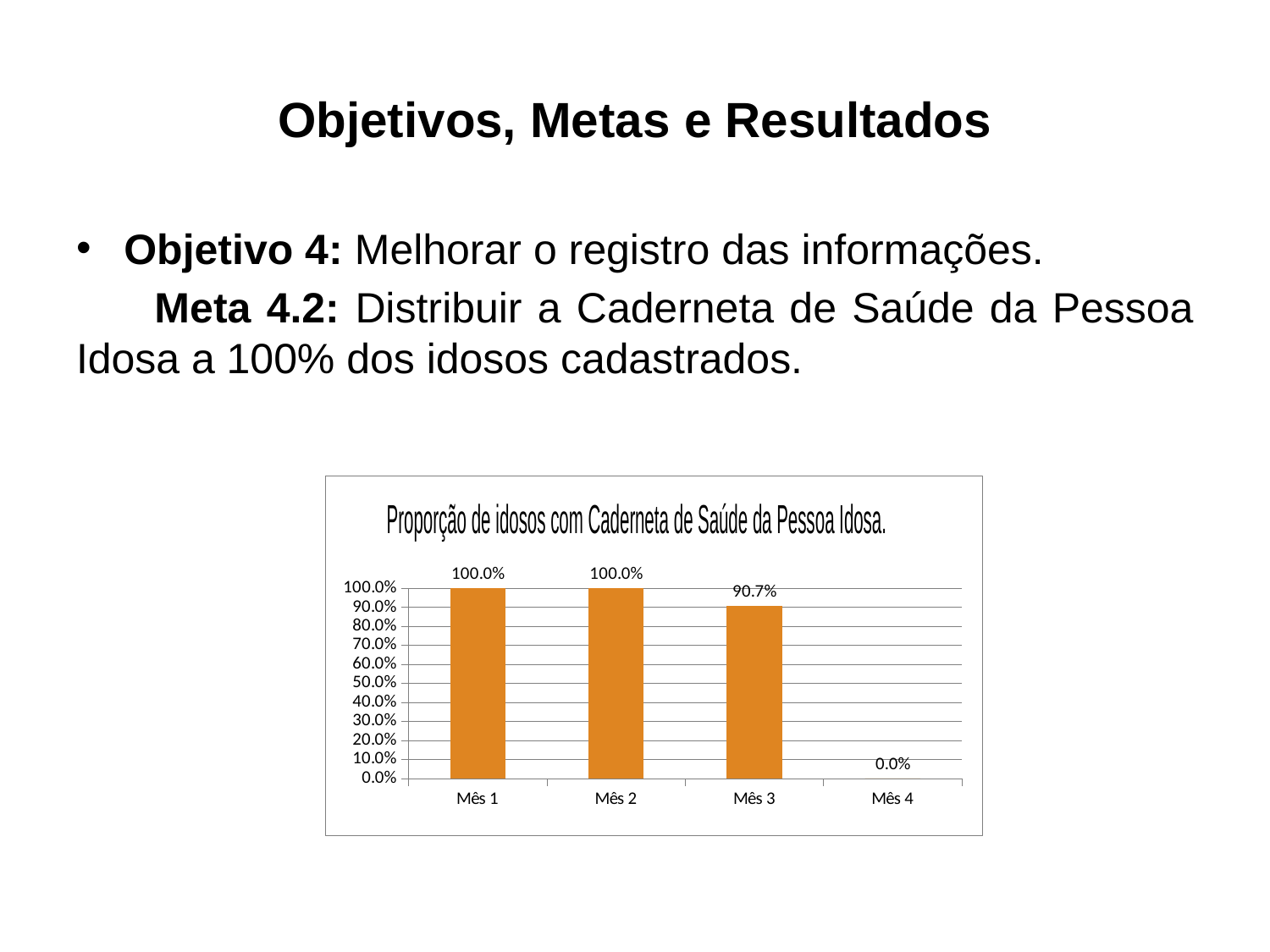
Which month has the lowest value? Mês 4 What is the title of the chart? Proporção de idosos com Caderneta de Saúde da Pessoa Idosa. What is the value for Mês 4? 0.0% What is the value for Mês 1? 100.0% What is the difference between the values for Mês 2 and Mês 3? 9.3% Do the values rise or fall from Mês 2 to Mês 4? fall How many months are shown on the x axis? 4 What colour are the bars in the chart? orange Is the value for Mês 3 greater or less than 80.0%? greater What is the value for Mês 3? 90.7% What kind of chart is shown on the slide? bar chart Which is larger, the value for Mês 1 or the value for Mês 3? Mês 1